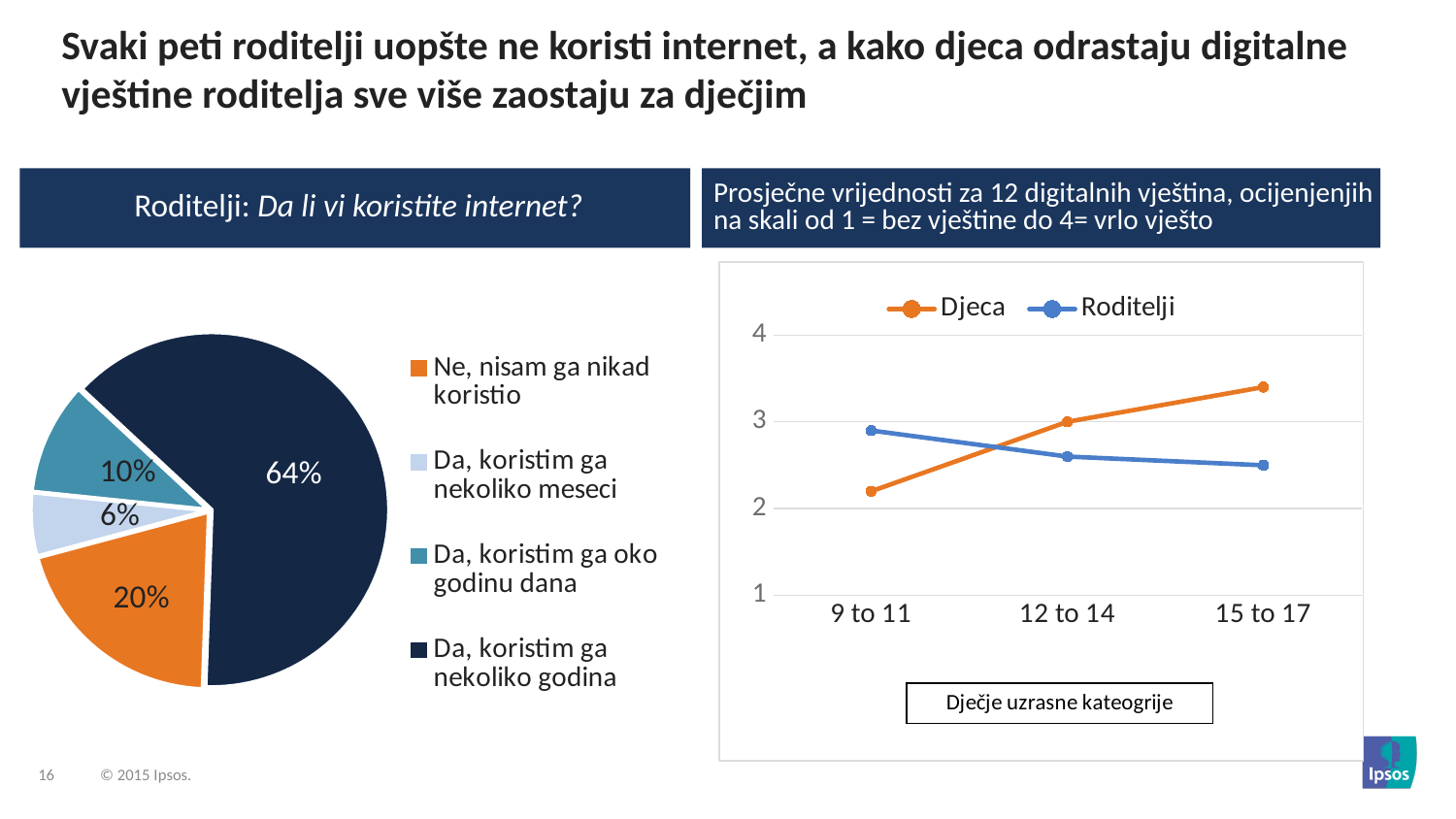
In the pie chart on the left, what share of parents answered "Da, koristim ga oko godinu dana"? 10% In the line chart on the right, which series has the higher value at "15 to 17", Djeca or Roditelji? Djeca In the line chart on the right, is the value for Djeca at "9 to 11" greater or less than 3? less In the pie chart on the left, what share of parents answered "Da, koristim ga nekoliko godina"? 64% How many series does the legend of the line chart on the right list? 2 How many slices does the pie chart on the left have? 4 In the line chart on the right, is the value for Djeca at "15 to 17" greater or less than 3? greater In the line chart on the right, do the values for Roditelji rise or fall across the age categories from "9 to 11" to "15 to 17"? fall What type of chart is shown on the right side of the slide? Line chart In the pie chart on the left, what is the difference in percentage points between "Da, koristim ga nekoliko godina" and "Ne, nisam ga nikad koristio"? 44 In the pie chart on the left, which answer has the smallest share? Da, koristim ga nekoliko meseci In the pie chart on the left, what share of parents answered "Ne, nisam ga nikad koristio"? 20%